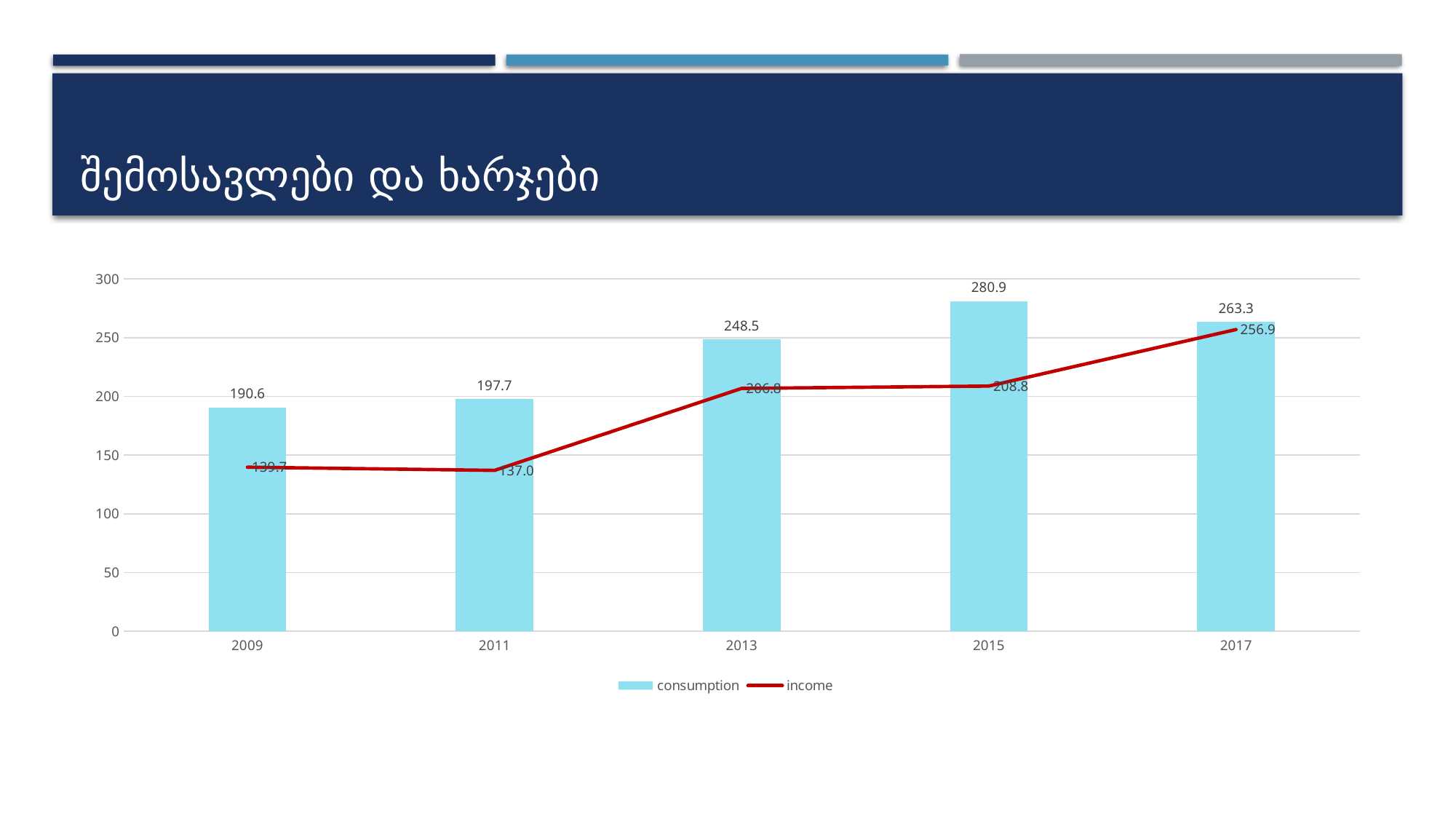
Is the consumption value for 2011 greater or less than 200? less How many series does the legend list? 2 What is the difference between consumption and income in 2013? 41.7 What is the income value for 2017? 256.9 What is the consumption value for 2009? 190.6 Which is larger in 2017, consumption or income? consumption How many years are shown on the x axis? 5 In which year is income lowest? 2011 In which year is consumption highest? 2015 Does income generally rise or fall from 2011 to 2017? rise What is the income value for 2011? 137.0 What is the consumption value for 2015? 280.9